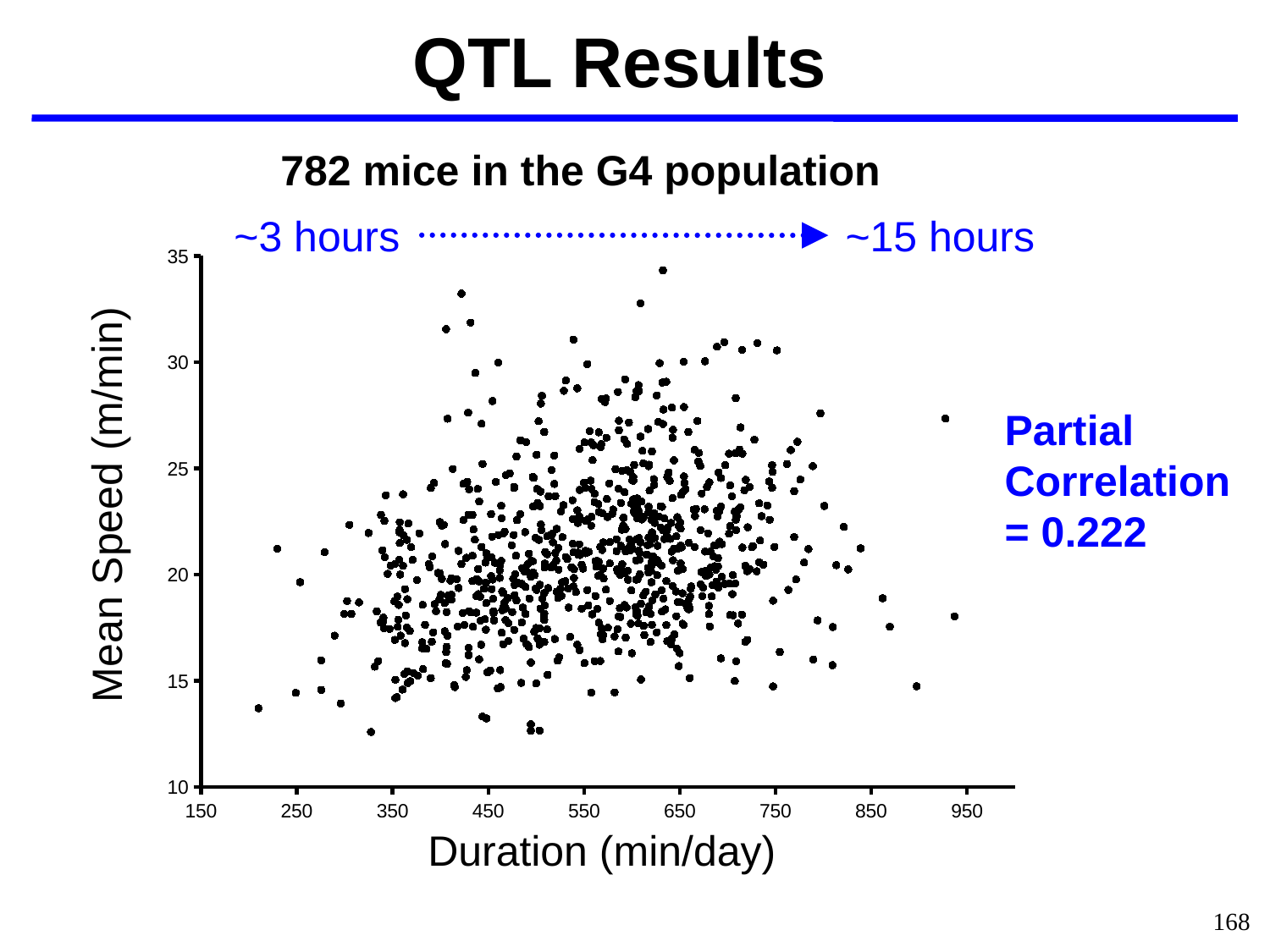
Is the largest duration plotted greater or less than 900 min/day? greater Is the smallest duration plotted greater or less than 250 min/day? less Is the highest mean speed plotted greater or less than 30 m/min? greater What kind of chart is shown on the slide? Scatter plot What is the lowest value shown on the y axis of the scatter plot? 10 How many mice are plotted in the scatter plot, according to the chart title? 782 What is the label of the y axis of the scatter plot? Mean Speed (m/min) What partial correlation value is reported next to the scatter plot? 0.222 What is the highest value shown on the x axis of the scatter plot? 950 As duration increases along the x axis, does mean speed tend to rise or fall? rise